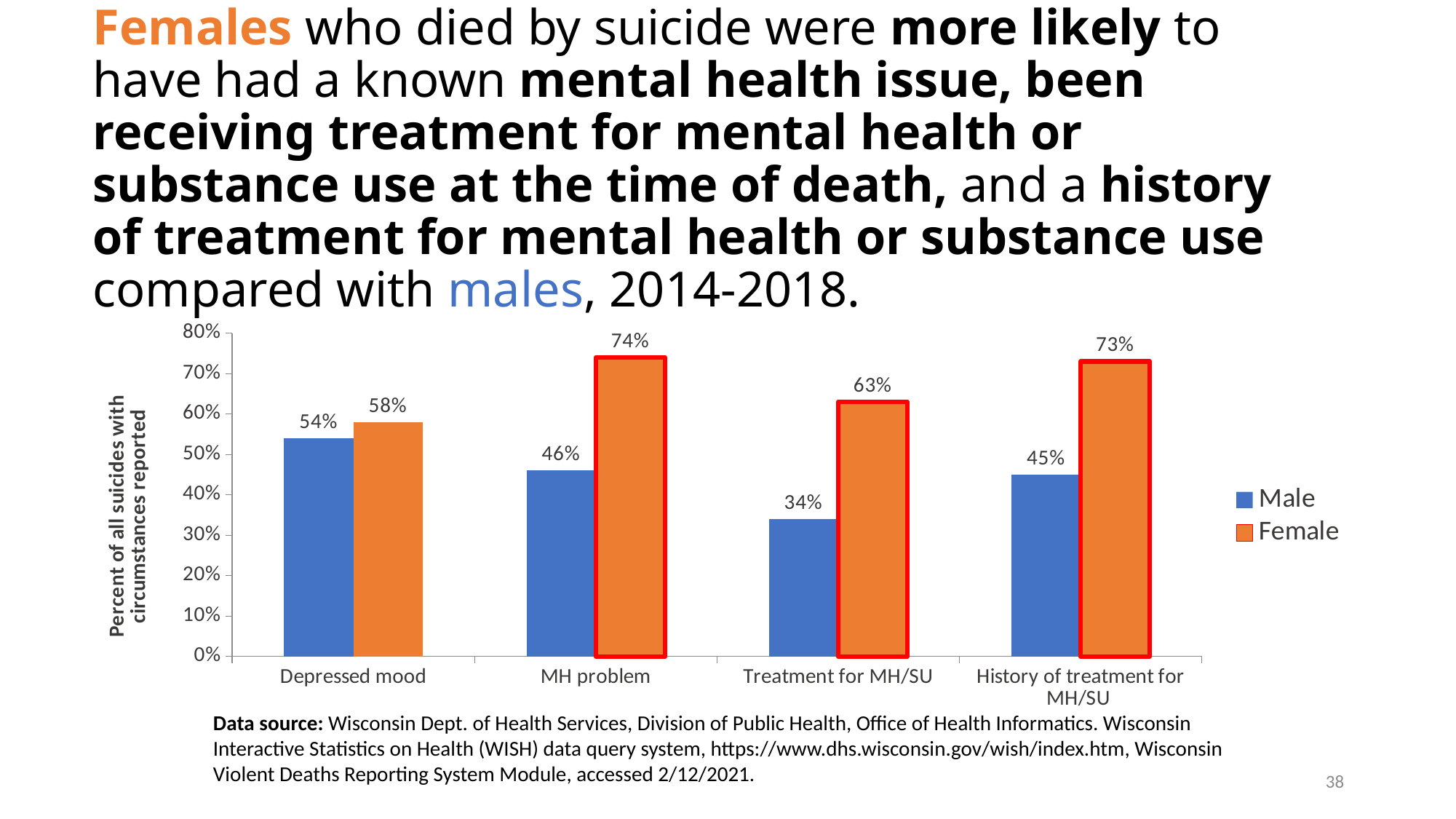
What is the Female value for MH problem? 74% Which is larger for Depressed mood, the Male value or the Female value? Female What is the Female value for Depressed mood? 58% What is the label of the y axis? Percent of all suicides with circumstances reported How many categories are shown on the x axis? 4 Which category has the highest Female value? MH problem What kind of chart is shown on the slide? Bar chart Which category has the lowest Male value? Treatment for MH/SU What is the difference between the Female and Male values for Treatment for MH/SU? 29% What is the Male value for Treatment for MH/SU? 34% What is the Male value for History of treatment for MH/SU? 45% How many series does the legend list? 2